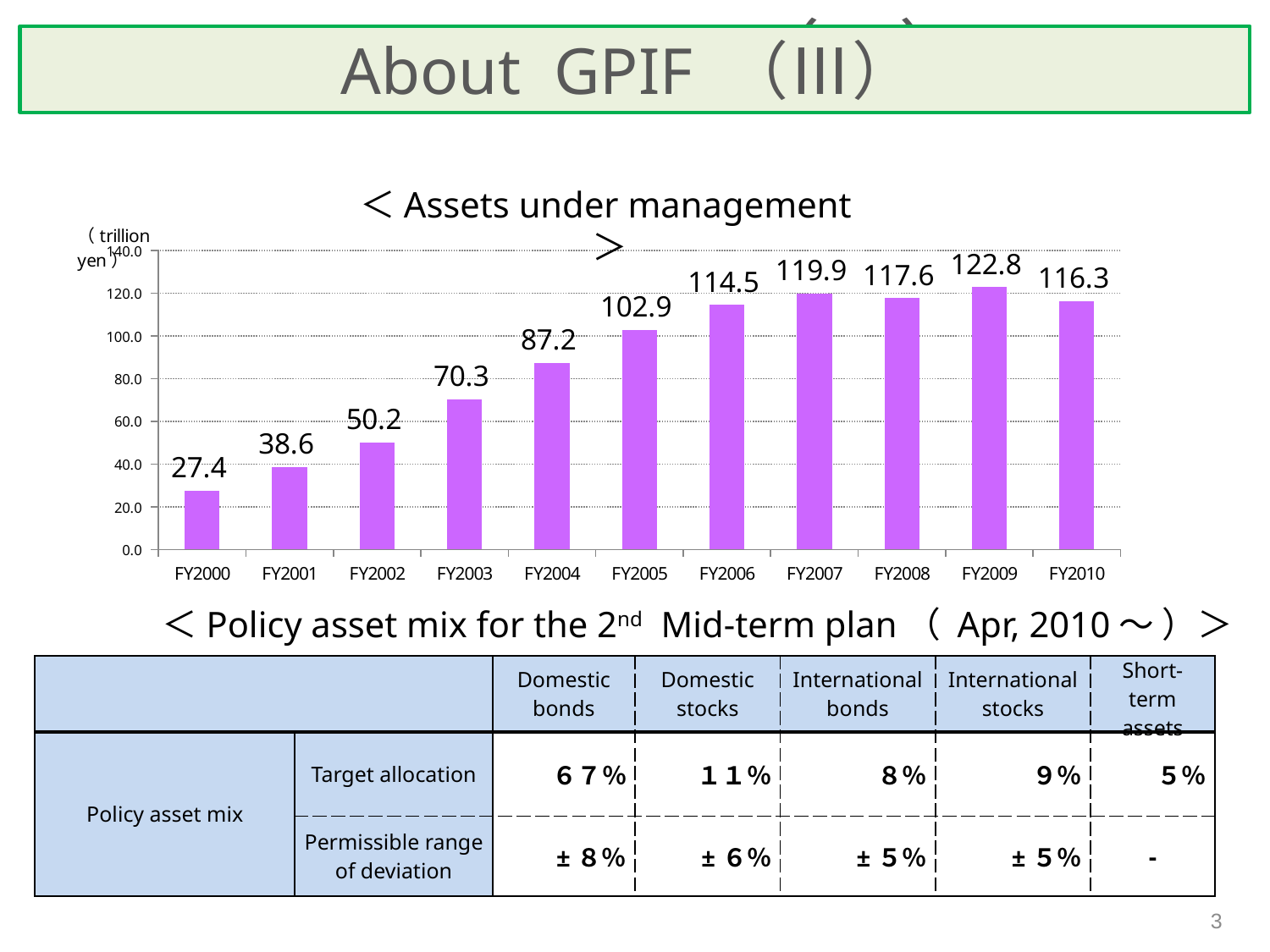
What is the value for FY2005 in the Assets under management chart? 102.9 Is the value for FY2004 greater or less than 100.0? less What kind of chart is the Assets under management chart? bar chart What is the value for FY2000 in the Assets under management chart? 27.4 How many fiscal years are shown in the Assets under management chart? 11 What is the difference between the FY2009 and FY2010 values in the Assets under management chart? 6.5 What is the value for FY2010 in the Assets under management chart? 116.3 Which is larger in the Assets under management chart, FY2007 or FY2008? FY2007 Which fiscal year has the highest assets under management? FY2009 What is the difference between the FY2001 and FY2000 values in the Assets under management chart? 11.2 Which fiscal year has the lowest assets under management? FY2000 What unit is shown on the y axis of the Assets under management chart? trillion yen